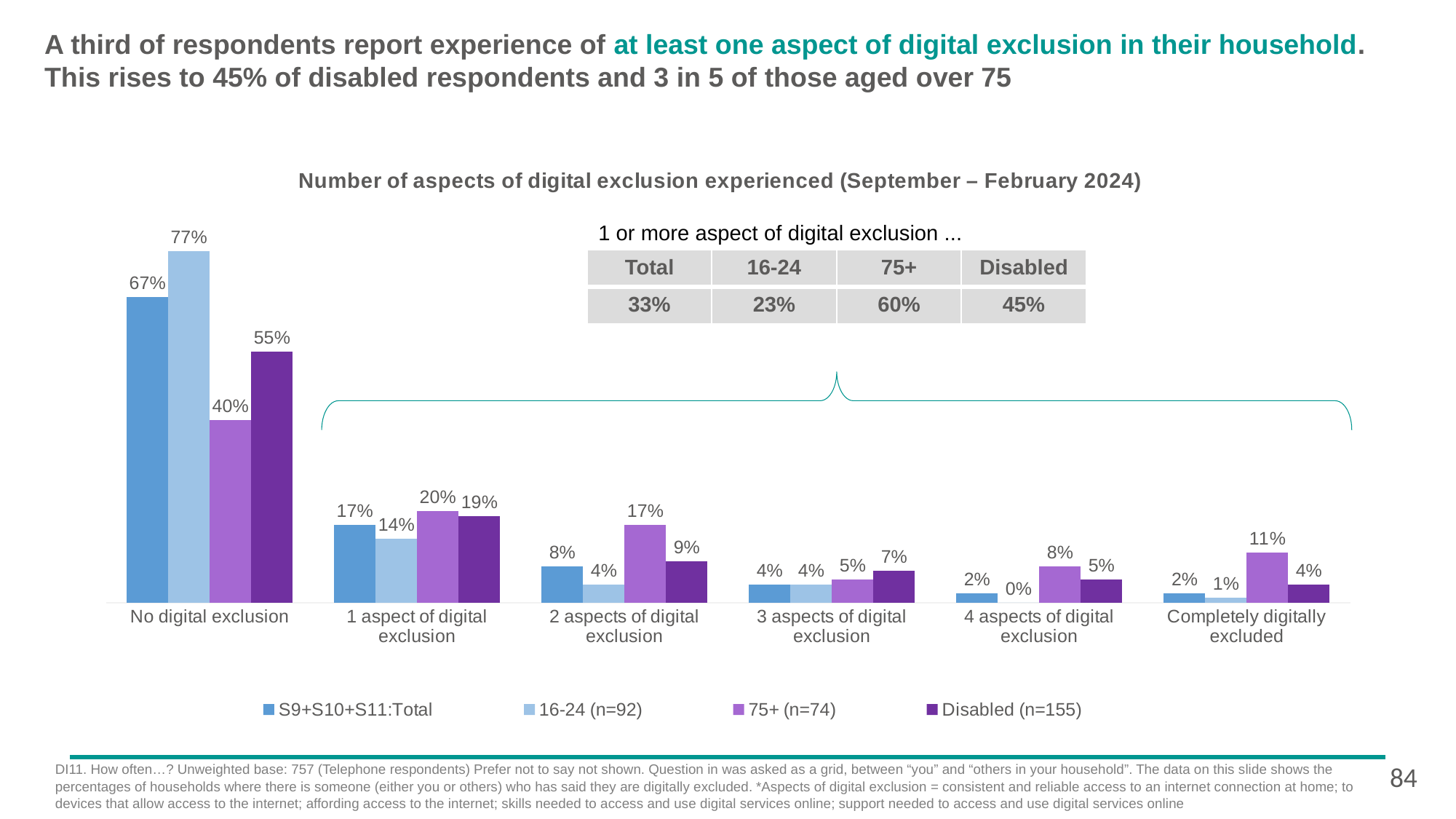
What is the value for the 75+ (n=74) series in the '2 aspects of digital exclusion' category? 17% How many series does the chart legend list? 4 What kind of chart is shown on the slide? Bar chart What is the value for the 16-24 (n=92) series in the 'No digital exclusion' category? 77% What is the value for the Disabled (n=155) series in the 'Completely digitally excluded' category? 4% What is the title of the chart? Number of aspects of digital exclusion experienced (September – February 2024) How many categories are shown on the x axis of the chart? 6 What is the difference between the S9+S10+S11:Total and 75+ (n=74) values in the 'No digital exclusion' category? 27% Which series has the lowest value in the '4 aspects of digital exclusion' category? 16-24 (n=92) Which series has the highest value in the 'No digital exclusion' category? 16-24 (n=92) Do the values for the S9+S10+S11:Total series rise or fall from 'No digital exclusion' to '4 aspects of digital exclusion'? Fall In the '1 aspect of digital exclusion' category, which is larger: the 75+ (n=74) value or the 16-24 (n=92) value? 75+ (n=74)